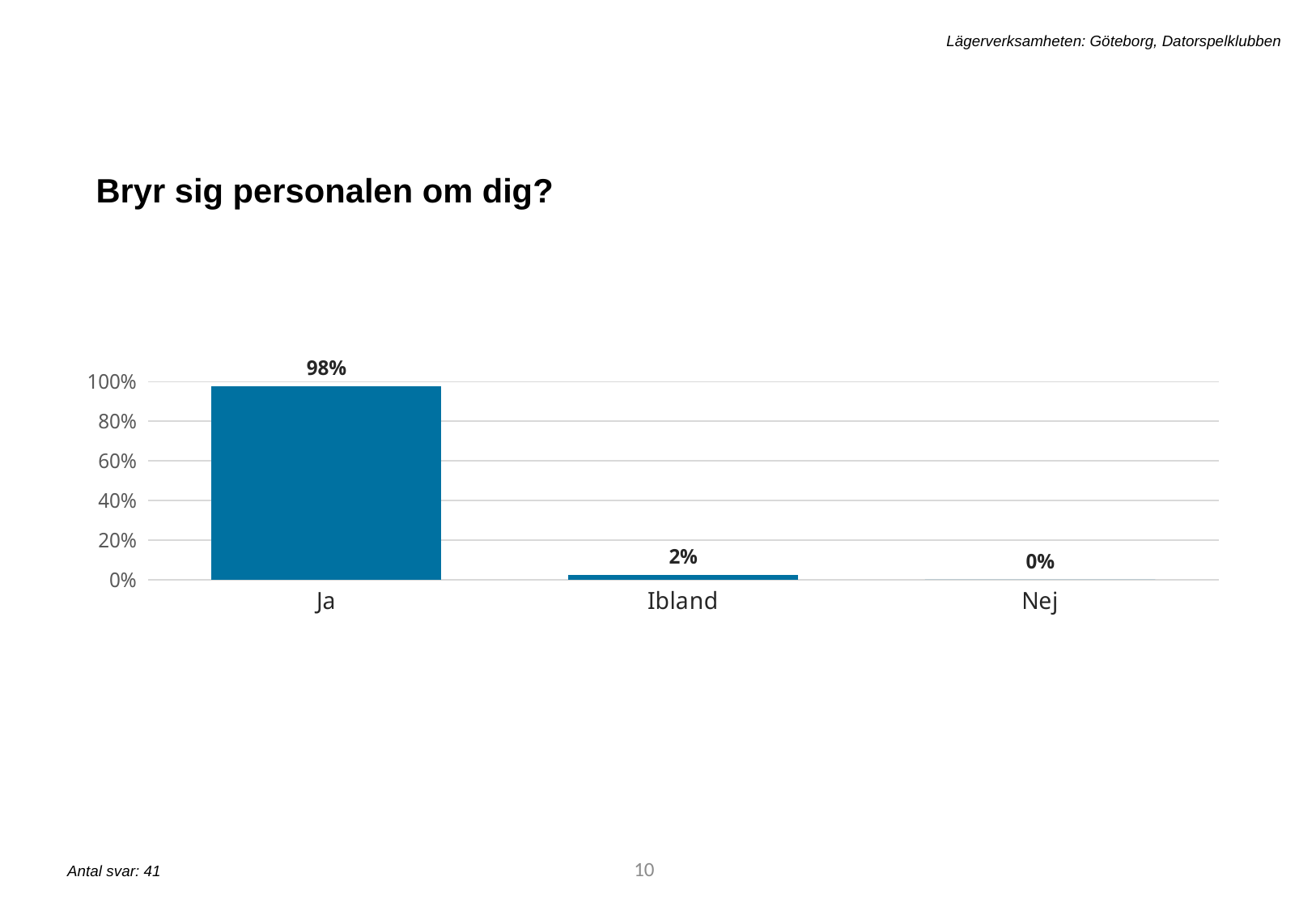
What is the value for Nej? 0% Which category has the lowest value? Nej Which category has the highest value? Ja What is the value for Ja? 98% What is the value for Ibland? 2% Is the value for Ibland greater or less than 20%? less Which is larger, the value for Ibland or the value for Nej? Ibland How many categories are shown on the x axis? 3 What kind of chart is shown on the slide? bar chart What is the difference between the values for Ja and Ibland? 96% Is the value for Ja greater or less than 80%? greater What is the title of the chart? Bryr sig personalen om dig?